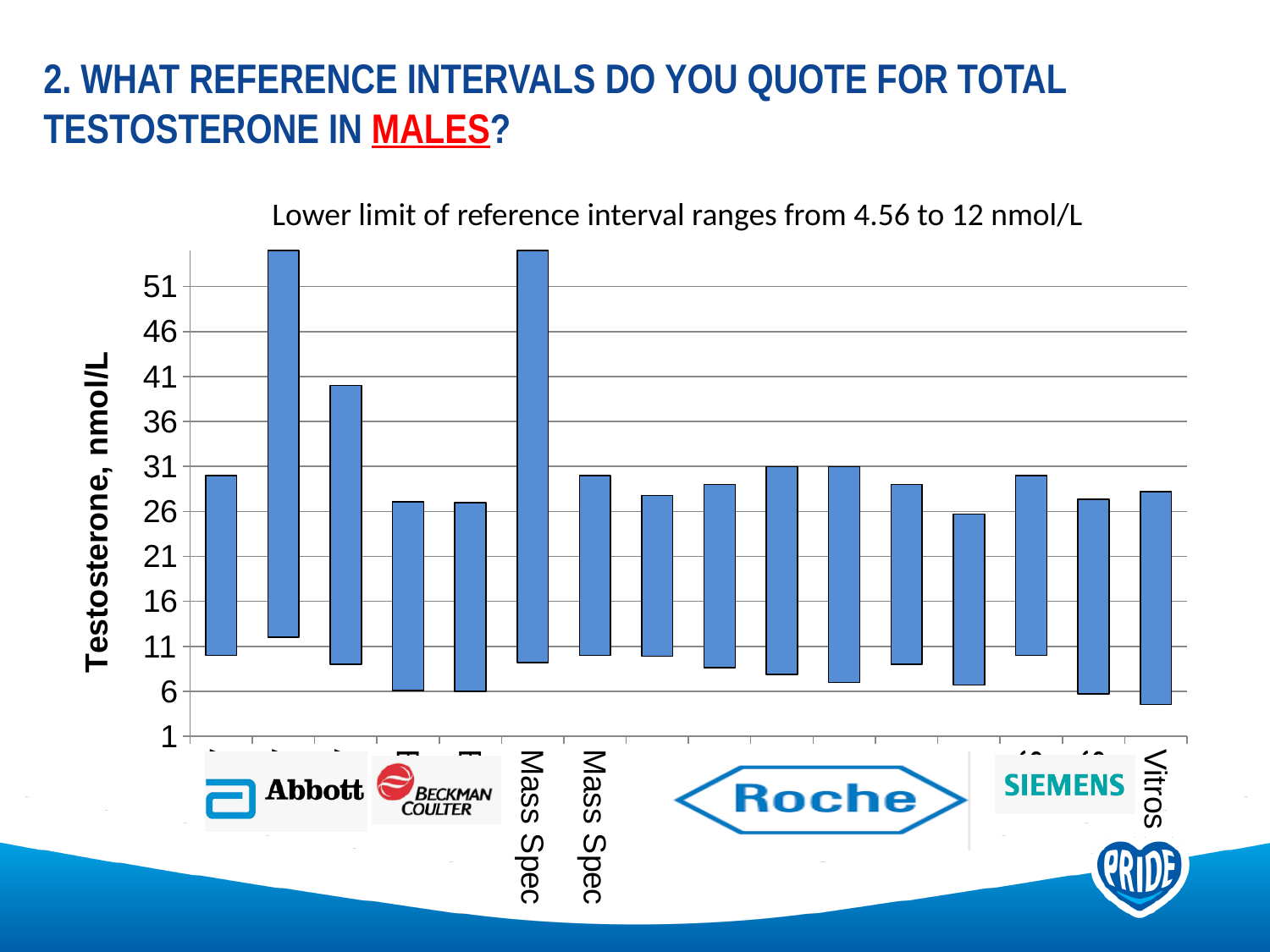
Is the top of the bar for Vitros greater or less than 26? greater Is the top of the first Mass Spec bar greater or less than 51? greater How many bars are plotted in the chart? 16 What is the highest tick value shown on the vertical axis? 51 Which of the two Mass Spec bars reaches a higher upper value, the first or the second? the first Is the top of the second Mass Spec bar greater or less than 26? greater According to the chart title, what is the lowest lower limit of the reference interval quoted? 4.56 What is the title of the chart? Lower limit of reference interval ranges from 4.56 to 12 nmol/L What is the label on the vertical axis of the chart? Testosterone, nmol/L What kind of chart is shown on the slide? bar chart